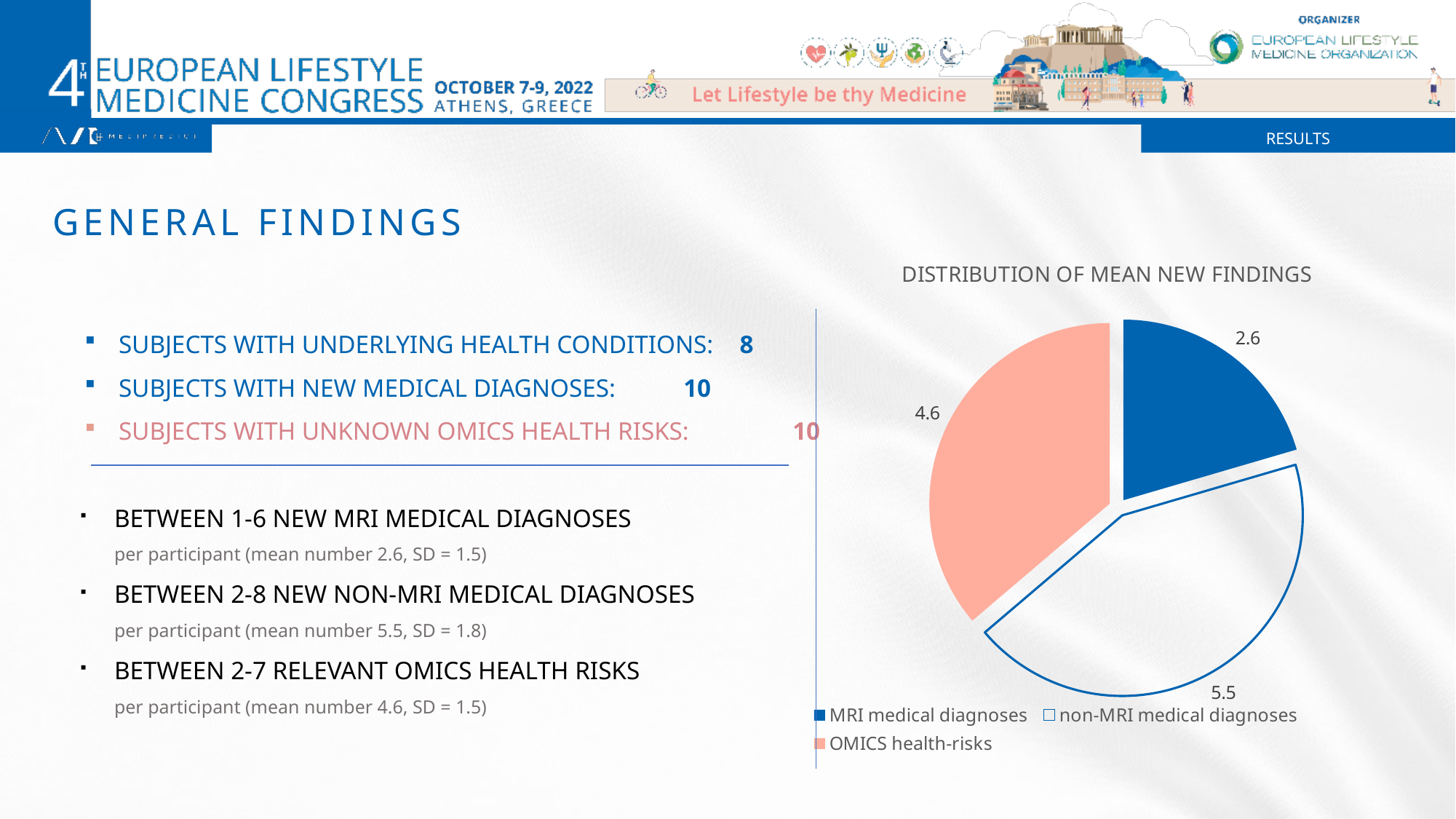
Which is larger, the value for OMICS health-risks or the value for non-MRI medical diagnoses? non-MRI medical diagnoses What is the value shown for non-MRI medical diagnoses in the pie chart? 5.5 What is the value shown for OMICS health-risks in the pie chart? 4.6 Which category has the smallest slice in the pie chart? MRI medical diagnoses What is the title of the chart? DISTRIBUTION OF MEAN NEW FINDINGS Which legend entry is shown in a salmon/pink colour? OMICS health-risks What is the value shown for MRI medical diagnoses in the pie chart? 2.6 How many slices does the pie chart have? 3 Which category has the largest slice in the pie chart? non-MRI medical diagnoses What is the difference between the non-MRI medical diagnoses value and the MRI medical diagnoses value? 2.9 What type of chart is shown on the slide? Pie chart What is the difference between the OMICS health-risks value and the MRI medical diagnoses value? 2.0